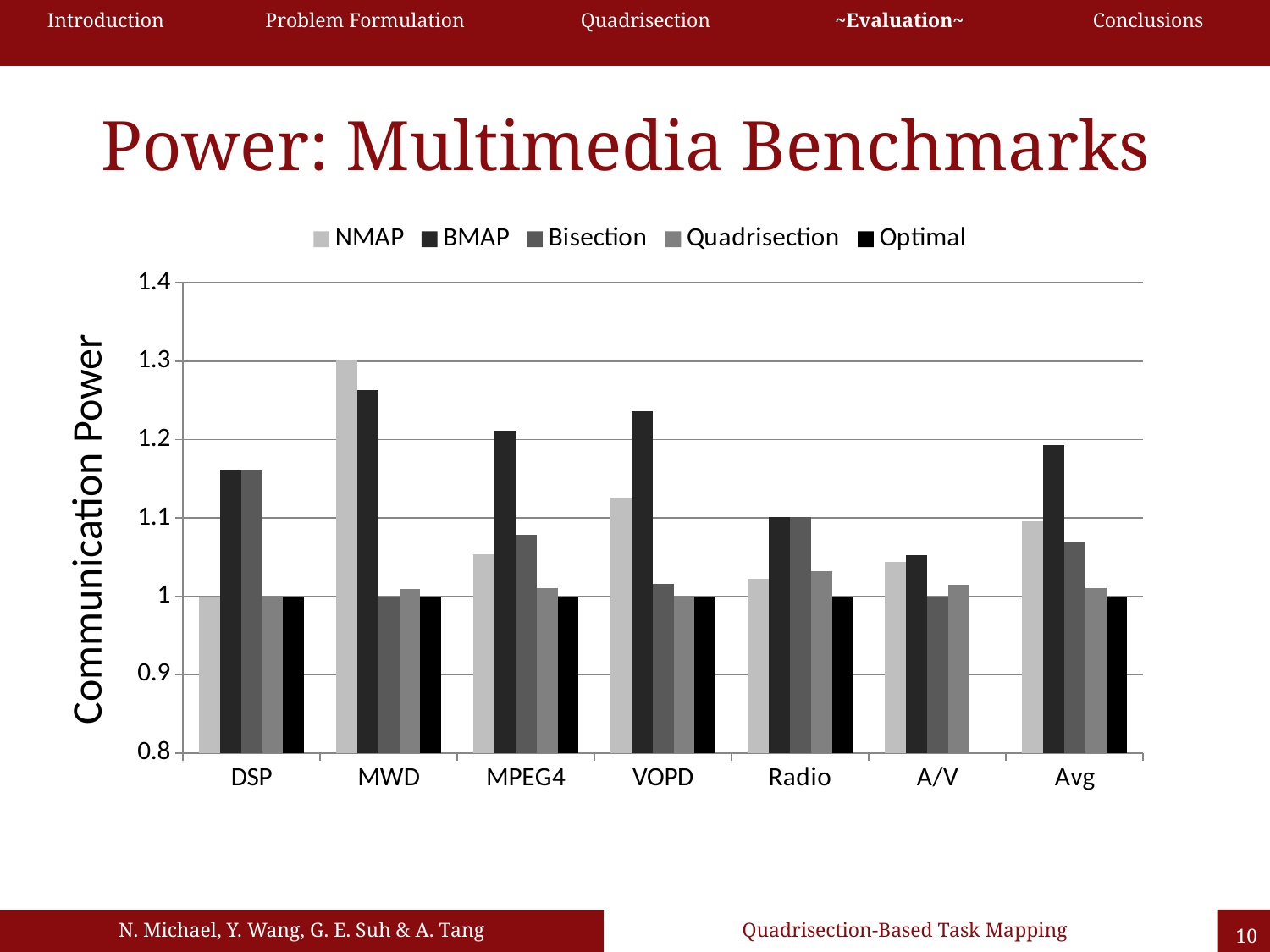
What is the Communication Power value for Optimal in the DSP category? 1 What kind of chart is shown on the slide? bar chart Is the NMAP value for VOPD greater or less than 1.2? less Which benchmark has the highest NMAP value? MWD How many series does the legend list? 5 How many benchmark categories are shown on the x axis? 7 What is the NMAP value for the MWD benchmark? 1.3 Is the Bisection value for MPEG4 greater or less than 1.1? less Is the BMAP value for MWD greater or less than 1.2? greater For the DSP benchmark, which is larger: BMAP or Quadrisection? BMAP What is the label on the y axis? Communication Power Which series has the lowest value in the Avg category? Optimal